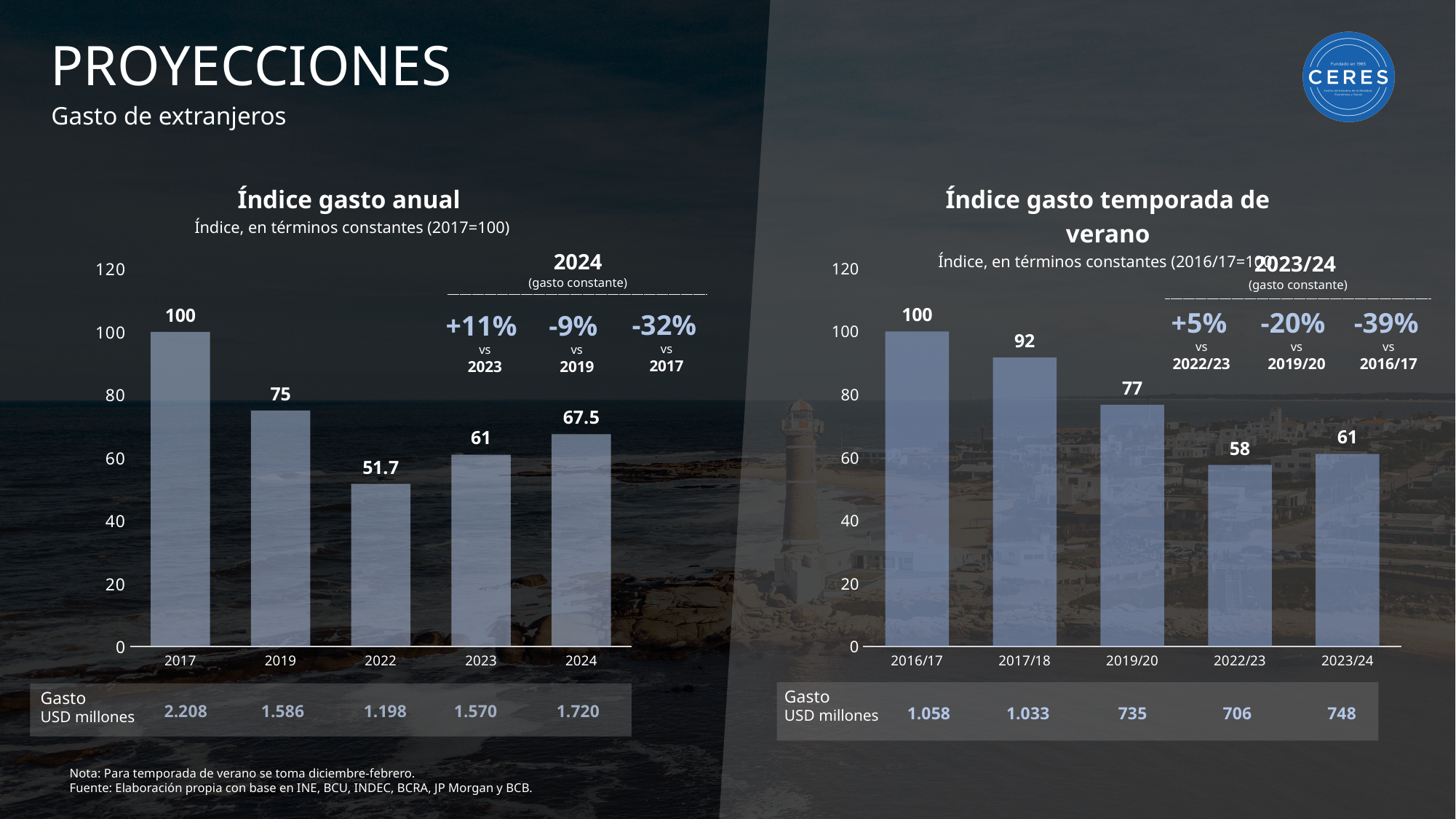
What type of chart is the 'Índice gasto anual' chart? Bar chart In the 'Índice gasto temporada de verano' chart, which season has the highest index value? 2016/17 In the 'Índice gasto temporada de verano' chart, what is the index value for 2022/23? 58 In the 'Índice gasto anual' chart, what is the index value for 2022? 51.7 In the 'Índice gasto temporada de verano' chart, what is the index value for 2017/18? 92 In the 'Índice gasto temporada de verano' chart, is the index value for 2019/20 larger than the value for 2023/24? Yes In the 'Índice gasto anual' chart, what is the index value for 2024? 67.5 In the 'Índice gasto temporada de verano' chart, what is the difference between the index values for 2016/17 and 2023/24? 39 In the 'Índice gasto anual' chart, what is the percentage change shown for 2024 vs 2017? -32% In the 'Índice gasto anual' chart, which year has the lowest index value? 2022 In the 'Índice gasto anual' chart, how many years are plotted? 5 In the 'Índice gasto anual' chart, what is the difference between the index values for 2019 and 2023? 14